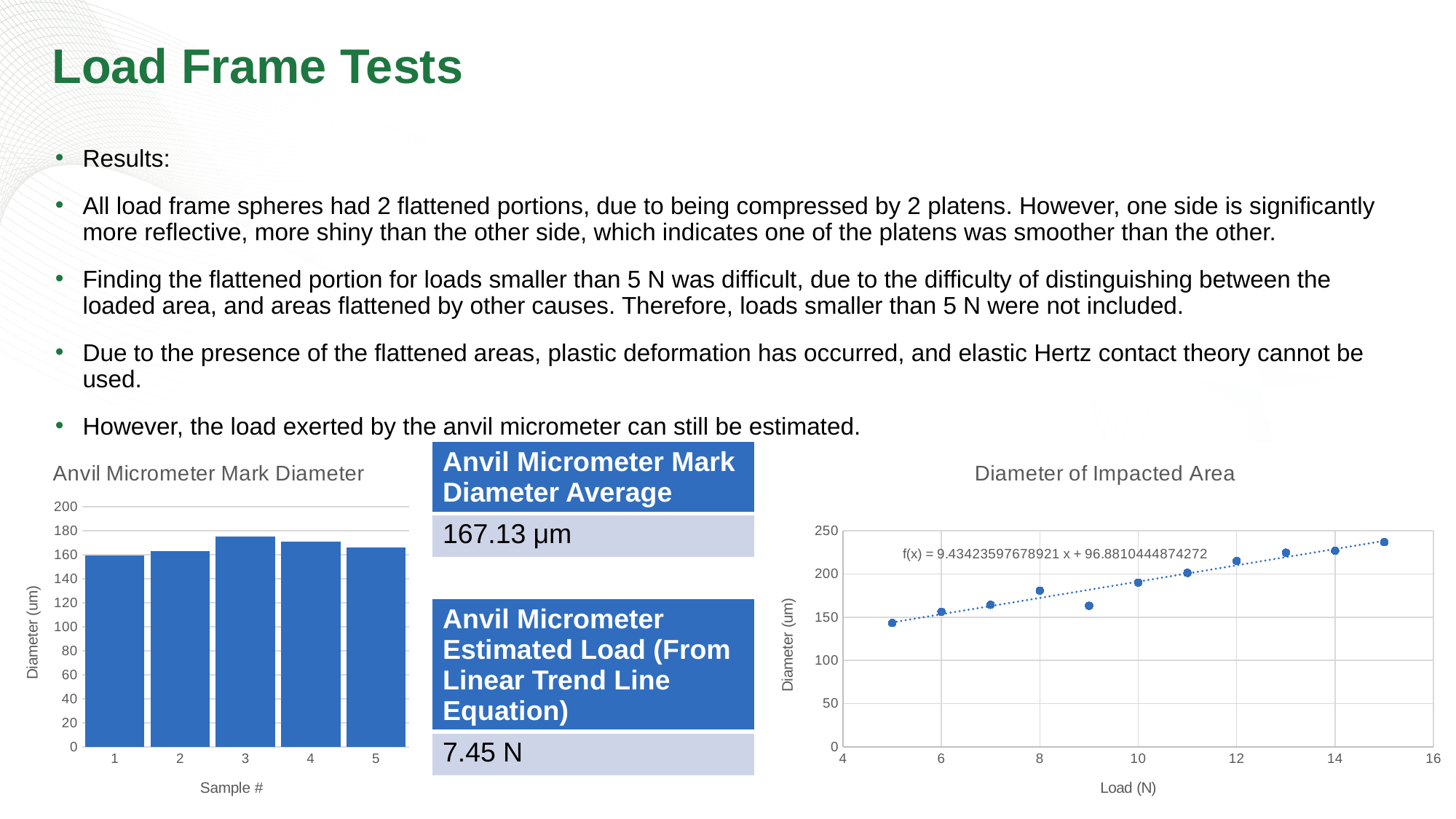
In the Anvil Micrometer Mark Diameter chart, is the diameter for sample 3 greater or less than 160? greater In the Anvil Micrometer Mark Diameter chart, how many samples are plotted? 5 In the Diameter of Impacted Area chart, what kind of chart is used? scatter chart In the Diameter of Impacted Area chart, what is the trend line equation shown? f(x) = 9.43423597678921 x + 96.8810444874272 In the Anvil Micrometer Mark Diameter chart, which has the larger diameter, sample 3 or sample 1? sample 3 In the Anvil Micrometer Mark Diameter chart, what kind of chart is used? bar chart In the Diameter of Impacted Area chart, how many data points are plotted? 11 In the Diameter of Impacted Area chart, is the diameter at a load of 15 N greater or less than 200? greater In the Diameter of Impacted Area chart, does the diameter rise or fall as the load increases? rise In the Anvil Micrometer Mark Diameter chart, is the diameter for sample 1 greater or less than 140? greater In the Anvil Micrometer Mark Diameter chart, what is the label of the x axis? Sample # In the Anvil Micrometer Mark Diameter chart, which sample has the largest diameter? 3